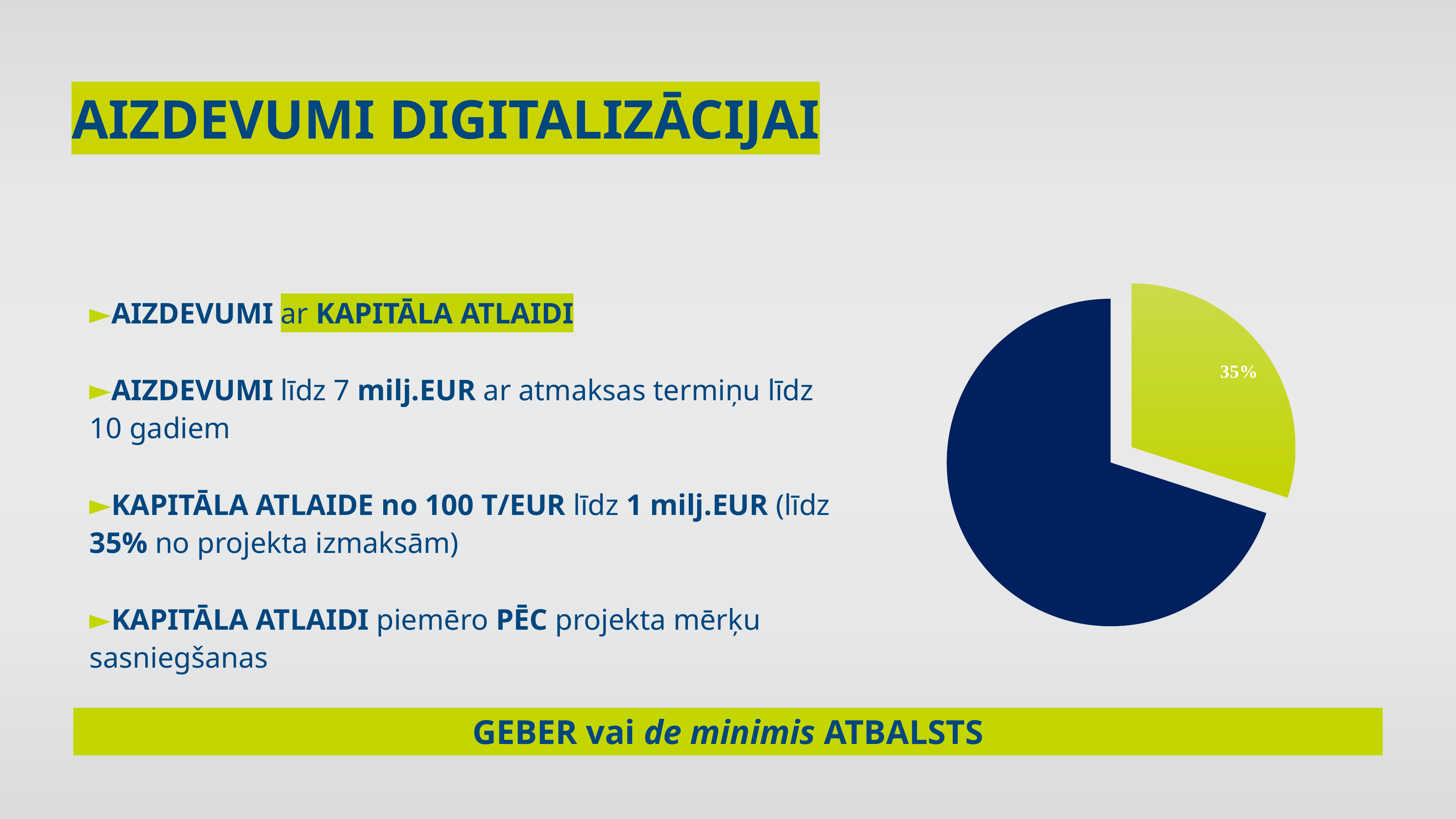
Which slice of the pie chart is larger, the dark blue one or the green one? dark blue Which slice of the pie chart is the smallest? the green slice (35%) Is the green slice of the pie chart greater or less than 50%? less Which slice of the pie chart is pulled out (exploded) from the rest of the pie? the green slice What share of the pie does the green slice represent? 35% What colour is the slice labelled 35% in the pie chart? green What value is printed on the green slice of the pie chart? 35% How many slices does the pie chart have? 2 Which slice of the pie chart is the largest? the dark blue slice How many slices of the pie chart have a data label printed on them? 1 What kind of chart is shown on the right side of the slide? pie chart